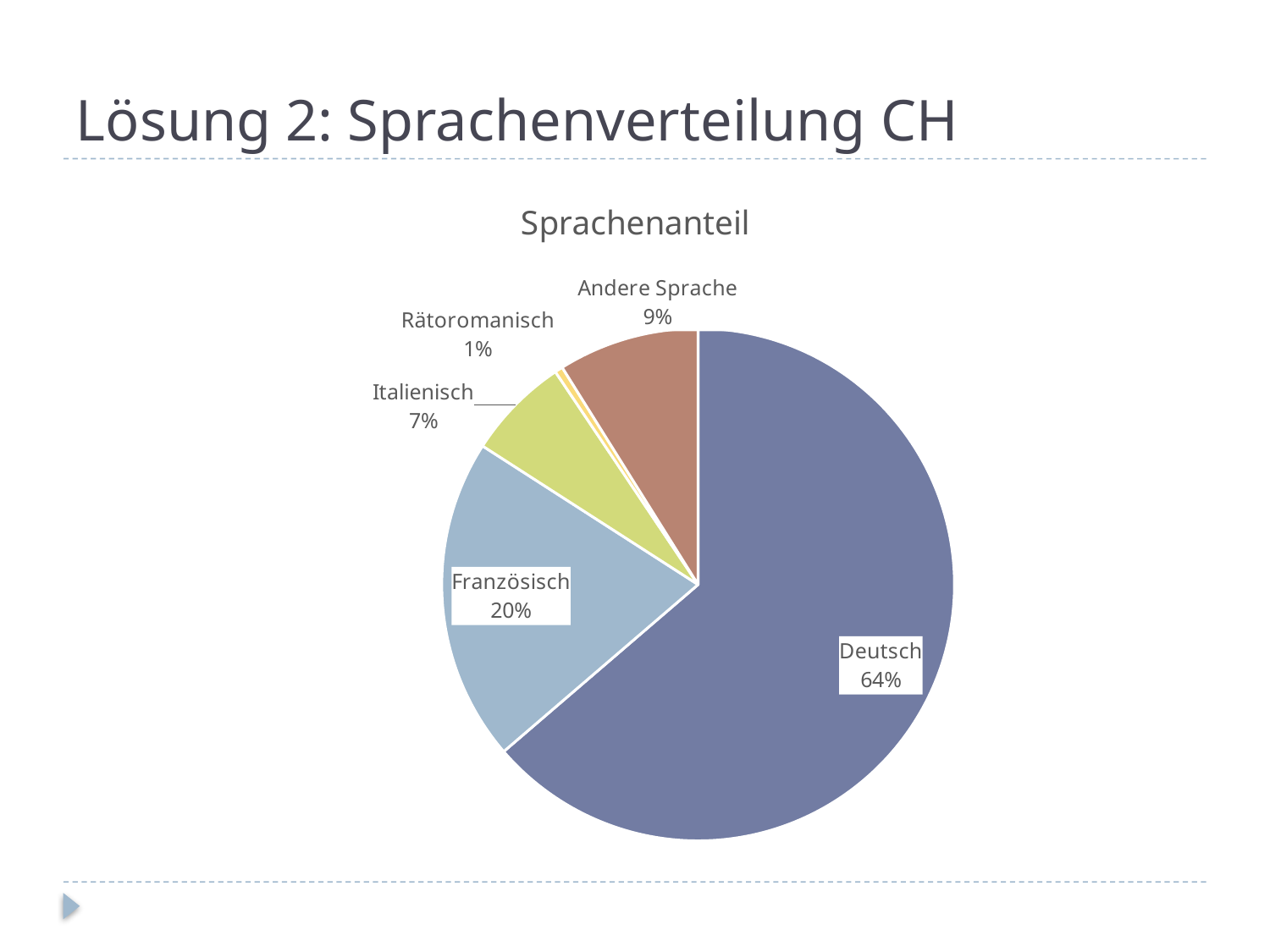
Which language has the smallest share in the pie chart? Rätoromanisch What share does Französisch have in the pie chart? 20% What share does Italienisch have in the pie chart? 7% What is the difference in percentage points between Deutsch and Französisch? 44 Which language has the largest share in the pie chart? Deutsch What share does Deutsch have in the pie chart? 64% What share does Rätoromanisch have in the pie chart? 1% Which has a larger share, Andere Sprache or Italienisch? Andere Sprache What kind of chart is shown on the slide? pie chart How many slices does the pie chart have? 5 What share does Andere Sprache have in the pie chart? 9% What is the title of the chart? Sprachenanteil